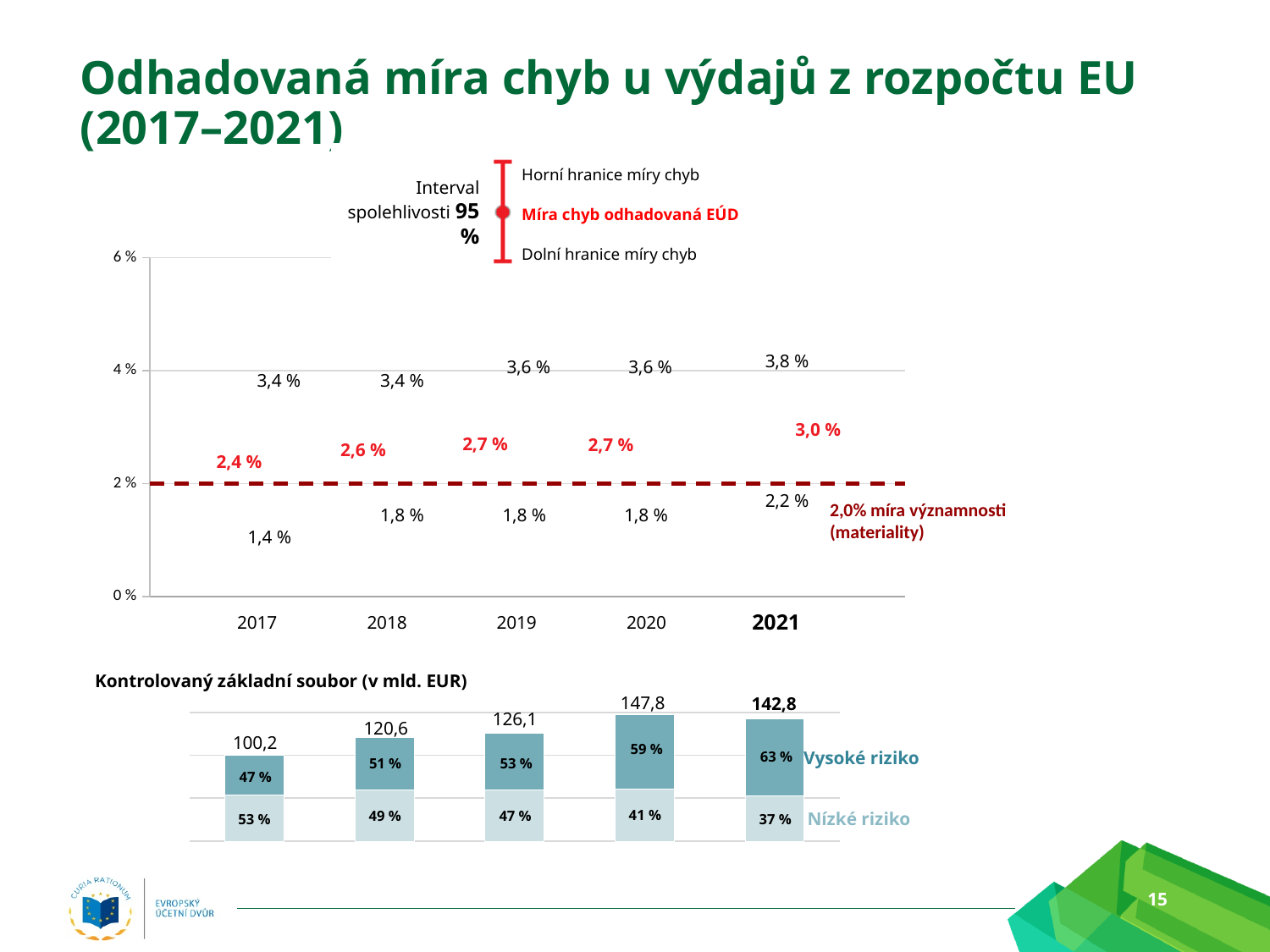
In the top chart, does the estimated error rate rise or fall from 2017 to 2021? rise In the top chart, what materiality threshold is marked by the dashed line? 2,0 % In the bottom chart (Kontrolovaný základní soubor), what is the total audited population for 2020 in bn EUR? 147,8 In the bottom chart, is the low-risk share (Nízké riziko) larger in 2017 or in 2021? 2017 In the top chart, which year has the lowest estimated error rate? 2017 In the top chart, what is the difference between the estimated error rate in 2021 and in 2017? 0,6 % In the bottom chart, what share of the 2021 audited population is high risk (Vysoké riziko)? 63 % In the top chart (Odhadovaná míra chyb), what is the estimated error rate (Míra chyb odhadovaná EÚD) for 2021? 3,0 % In the bottom chart, which year has the largest total audited population? 2020 In the top chart, what is the upper bound of the error rate (Horní hranice míry chyb) for 2017? 3,4 % In the top chart, what is the lower bound of the error rate (Dolní hranice míry chyb) for 2019? 1,8 % In the top chart, which year has the highest estimated error rate? 2021